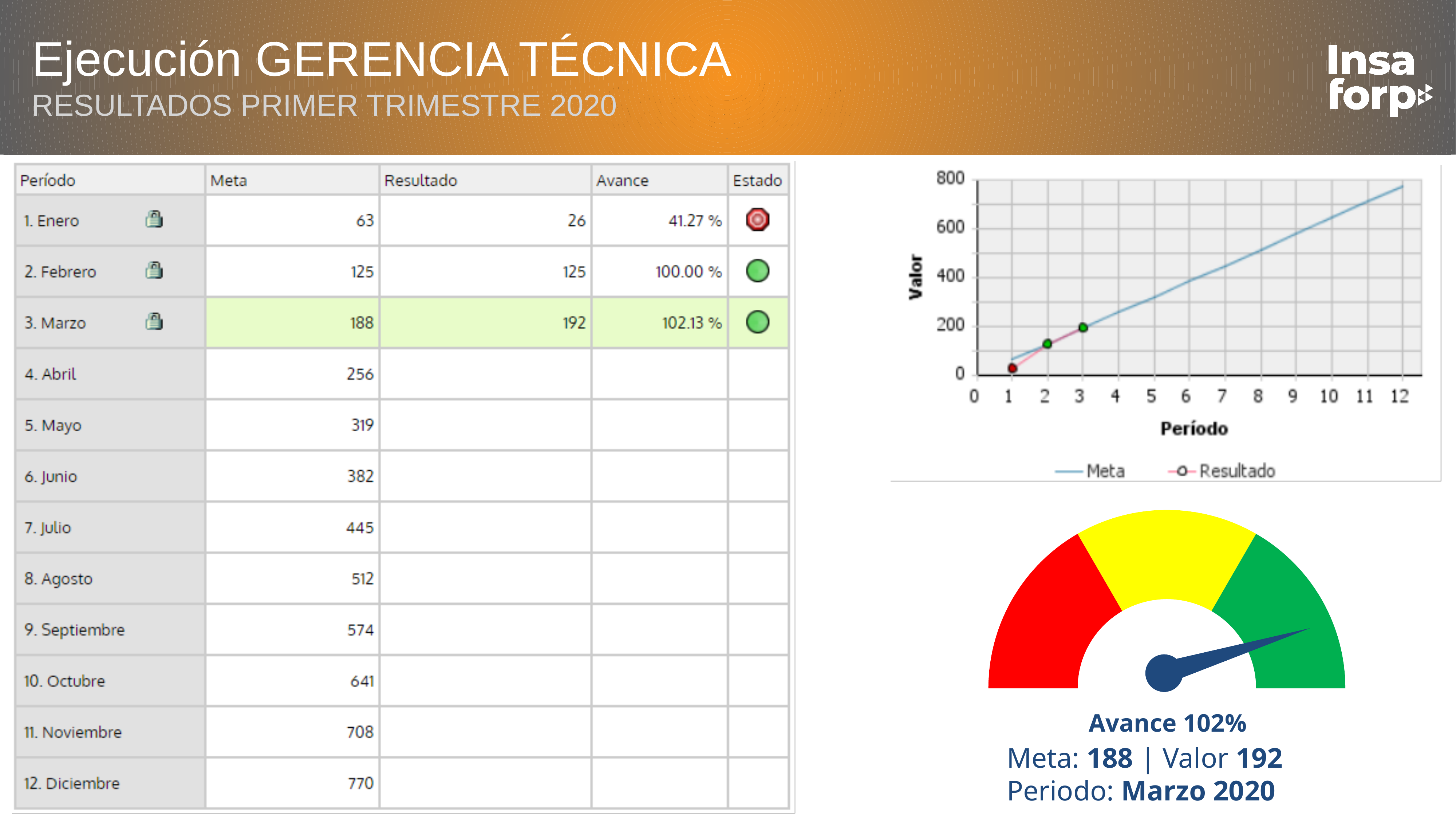
In the gauge chart at the bottom right, which coloured zone does the needle point into? green In the gauge chart at the bottom right, what is the Valor shown? 192 In the gauge chart at the bottom right, what Avance percentage is shown? 102% In the top-right line chart, is the Resultado value at Período 3 greater or less than 400? less In the top-right line chart, how many Resultado data points are plotted? 3 In the top-right line chart, does the Meta line rise or fall as the Período increases from 1 to 12? rises What kind of chart is the chart at the top right with Meta and Resultado? line chart In the top-right line chart, what are the two series named in the legend? Meta and Resultado In the gauge chart at the bottom right, what is the Meta value shown? 188 In the top-right line chart, is the Meta value at Período 12 greater or less than 600? greater In the top-right line chart, how many series does the legend list? 2 In the gauge chart at the bottom right, what is the difference between the Valor and the Meta? 4